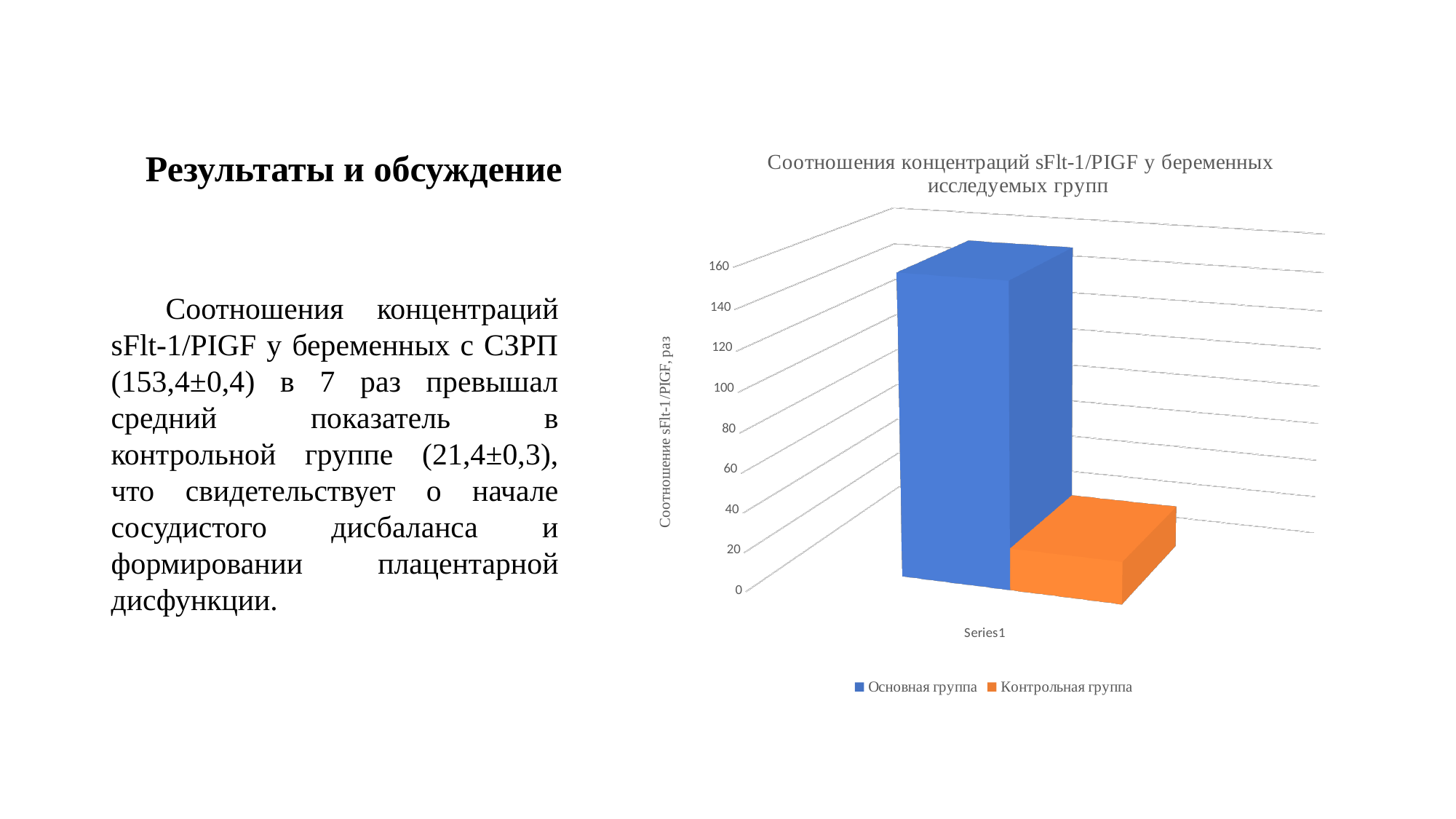
Is the value for Основная группа greater or less than 60? greater Which series has the lowest bar? Контрольная группа What is the title of the chart? Соотношения концентраций sFlt-1/PIGF у беременных исследуемых групп Which is larger, the value for Основная группа or the value for Контрольная группа? Основная группа How many categories are shown on the x axis of the chart? 1 What is the label of the vertical axis of the chart? Соотношение sFlt-1/PIGF, раз How many series does the legend list? 2 What kind of chart is shown on the slide? bar chart Is the value for Контрольная группа greater or less than 40? less Which series has the highest bar? Основная группа Is the value for Основная группа greater or less than 100? greater